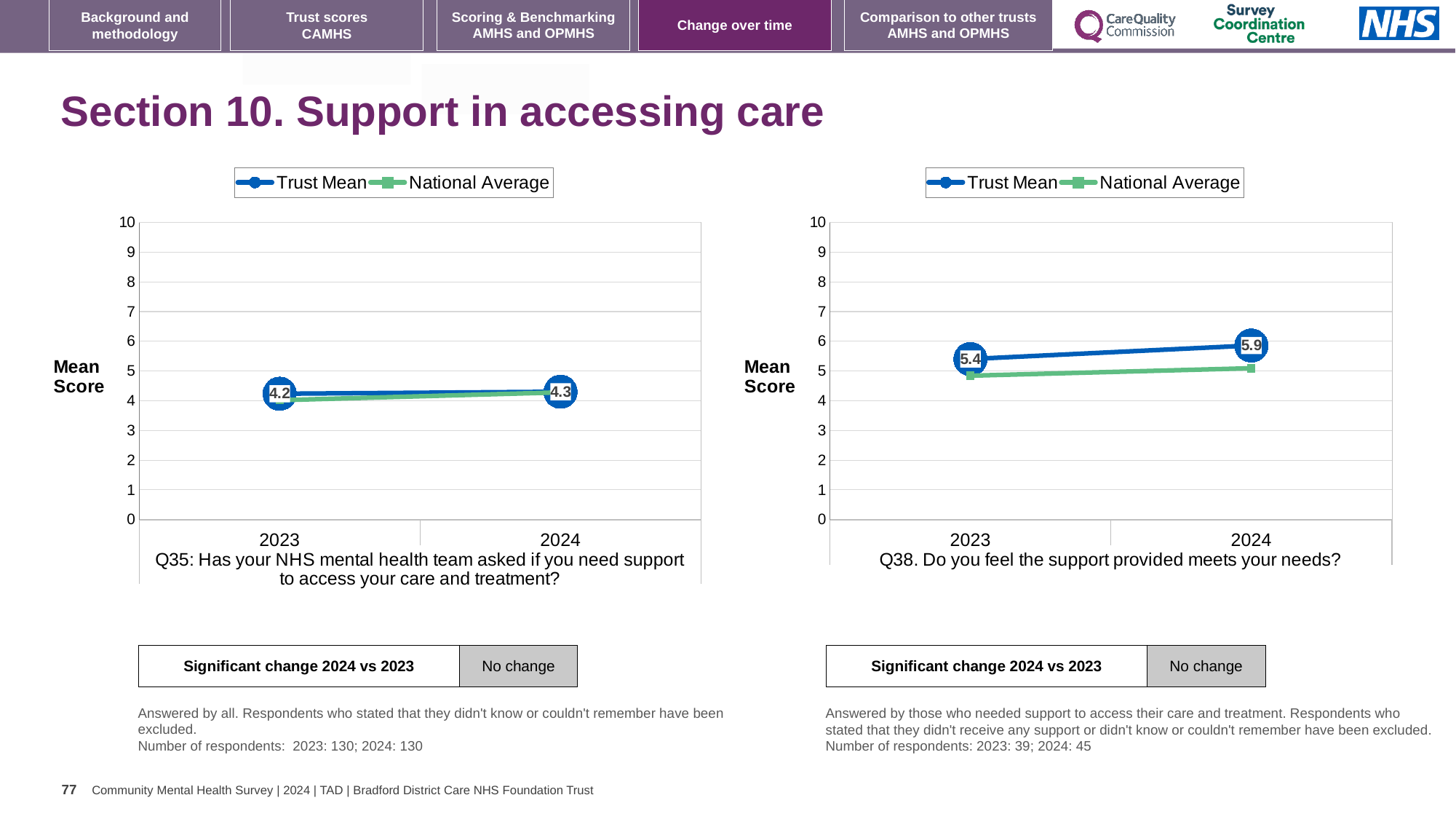
How many years are shown on the x axis of the Q38 chart on the right? 2 In the Q38 chart on the right, which is larger in 2024, the Trust Mean or the National Average? Trust Mean In the Q38 chart on the right, what is the Trust Mean for 2024? 5.9 In the Q38 chart on the right, is the National Average for 2023 greater or less than 5? less In the Q38 chart on the right, by how much did the Trust Mean change from 2023 to 2024? 0.5 In the Q35 chart on the left, what is the difference between the Trust Mean in 2024 and in 2023? 0.1 In the Q35 chart on the left, what is the Trust Mean for 2023? 4.2 In the Q35 chart on the left, what is the Trust Mean for 2024? 4.3 What type of chart is the Q35 chart on the left? line chart In the Q38 chart on the right, does the Trust Mean rise or fall from 2023 to 2024? rise How many series does the legend of the Q35 chart on the left list? 2 In the Q38 chart on the right, what is the Trust Mean for 2023? 5.4